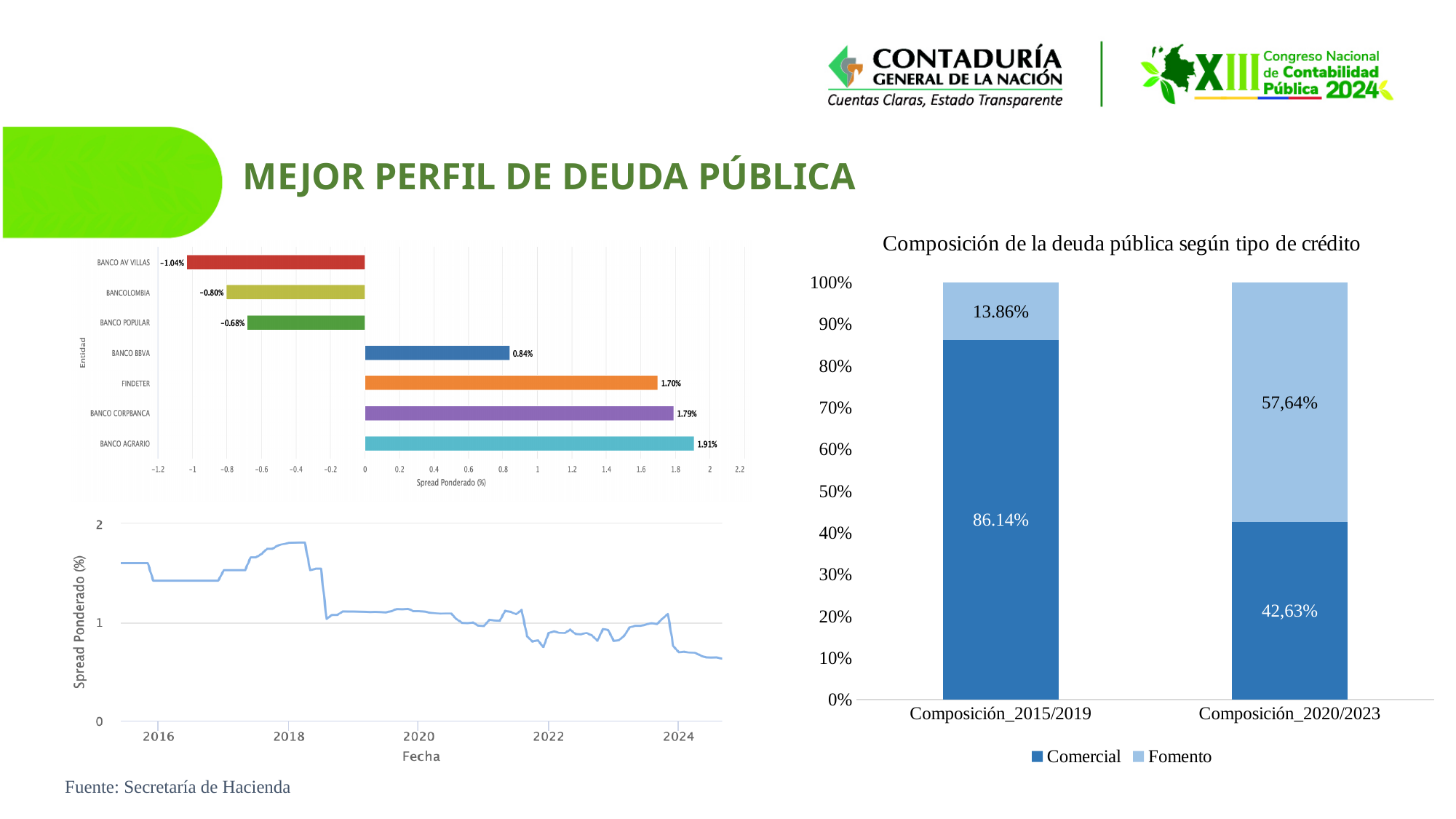
What kind of chart is 'Composición de la deuda pública según tipo de crédito'? stacked bar chart In the top-left bar chart of spread ponderado by entidad, what is the value for BANCO AGRARIO? 1.91% In the top-left bar chart of spread ponderado by entidad, which is larger, the value for FINDETER or the value for BANCO BBVA? FINDETER In the top-left bar chart of spread ponderado by entidad, which entidad has the lowest value? BANCO AV VILLAS In the chart 'Composición de la deuda pública según tipo de crédito', what is the Comercial share for Composición_2015/2019? 86.14% In the top-left bar chart of spread ponderado by entidad, how many entidades are shown? 7 In the top-left bar chart of spread ponderado by entidad, what is the value for BANCO AV VILLAS? -1.04% In the chart 'Composición de la deuda pública según tipo de crédito', what is the Fomento share for Composición_2020/2023? 57,64% In the chart 'Composición de la deuda pública según tipo de crédito', how many series does the legend list? 2 In the bottom-left line chart of spread ponderado over fecha, do the values generally rise or fall from 2016 to 2024? fall In the bottom-left line chart of spread ponderado over fecha, is the value at 2024 greater or less than 1? less In the top-left bar chart of spread ponderado by entidad, which entidad has the highest value? BANCO AGRARIO